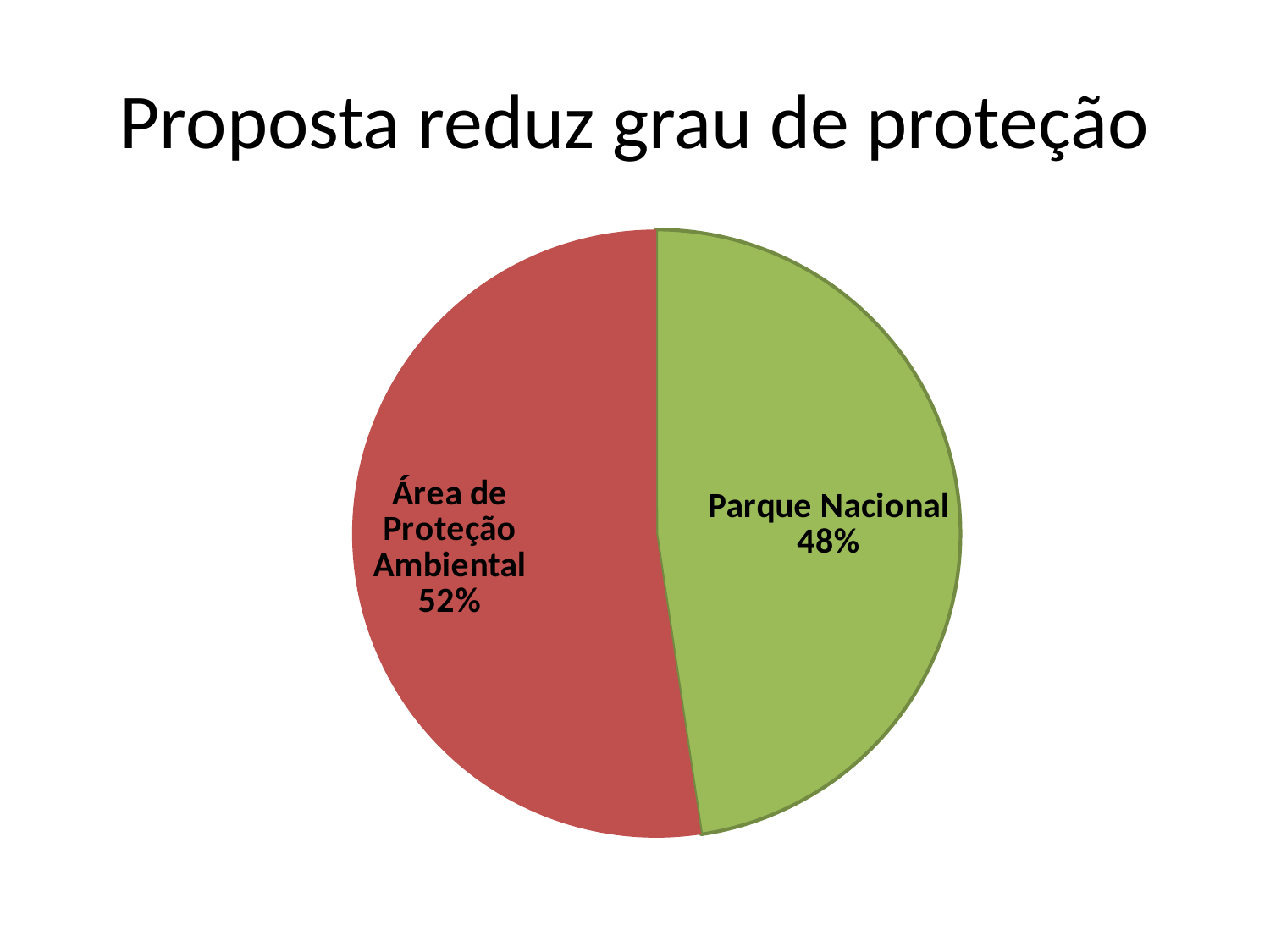
What type of chart is shown on the slide? pie chart Which slice is the largest? Área de Proteção Ambiental How many slices does the pie chart have? 2 What share of the pie does Área de Proteção Ambiental represent? 52% What is the title of the slide? Proposta reduz grau de proteção What colour is the Parque Nacional slice? green What share of the pie does Parque Nacional represent? 48% Which is larger, Parque Nacional or Área de Proteção Ambiental? Área de Proteção Ambiental What is the difference in percentage points between Área de Proteção Ambiental and Parque Nacional? 4 Which slice is the smallest? Parque Nacional